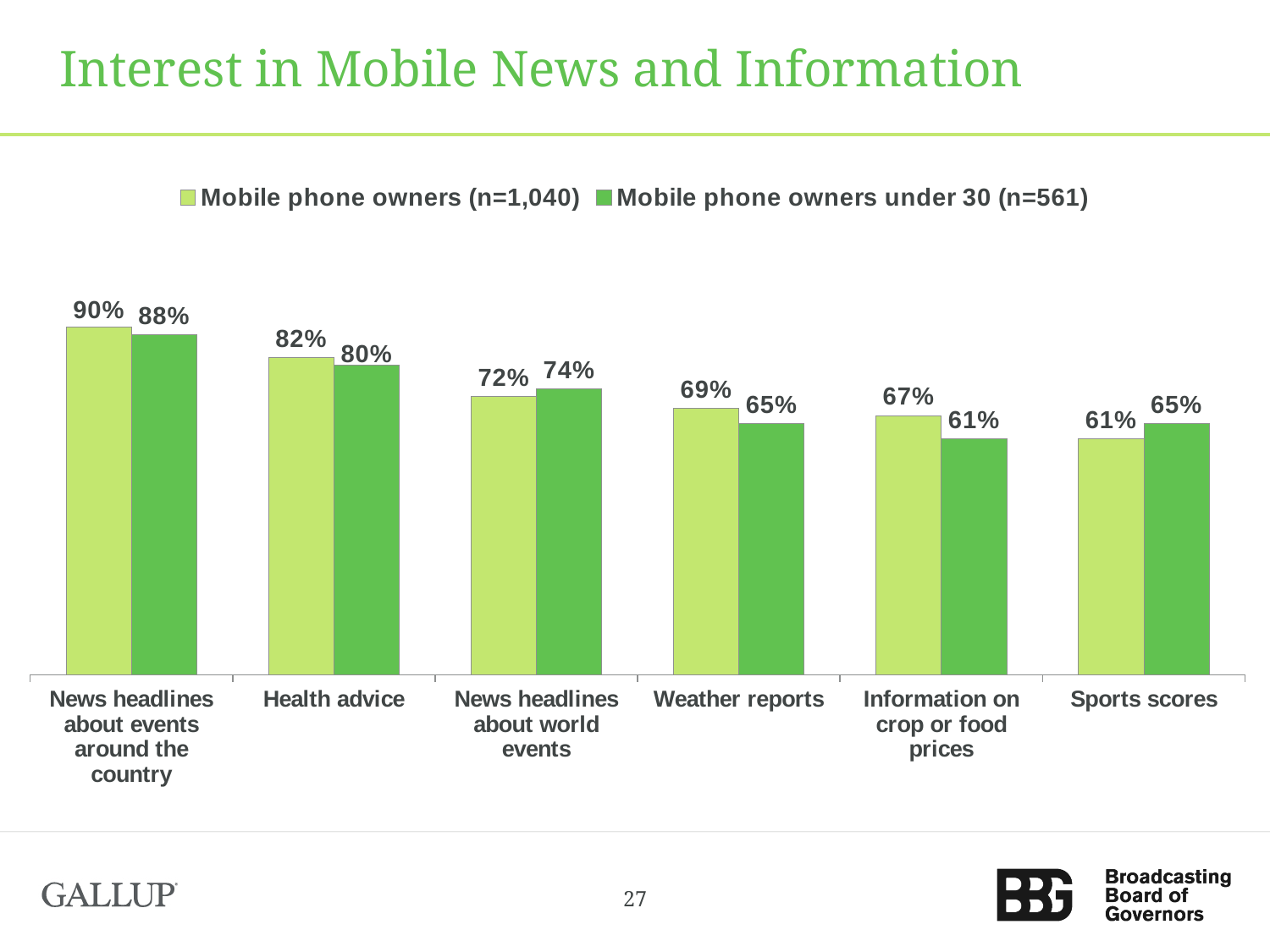
Which category has the highest value for mobile phone owners under 30 (n=561)? News headlines about events around the country How many categories are shown on the x axis? 6 What kind of chart is shown on the slide? Bar chart For news headlines about world events, which series has the larger value: mobile phone owners (n=1,040) or mobile phone owners under 30 (n=561)? Mobile phone owners under 30 (n=561) What is the difference between mobile phone owners (n=1,040) and mobile phone owners under 30 (n=561) for information on crop or food prices? 6% What percentage of mobile phone owners (n=1,040) are interested in news headlines about events around the country? 90% Do the values for mobile phone owners (n=1,040) rise or fall from left to right across the categories? Fall Which category has the lowest value for mobile phone owners (n=1,040)? Sports scores What is the value for mobile phone owners (n=1,040) for information on crop or food prices? 67% What is the title of the chart? Interest in Mobile News and Information How many series does the legend list? 2 What is the value for mobile phone owners under 30 (n=561) for sports scores? 65%